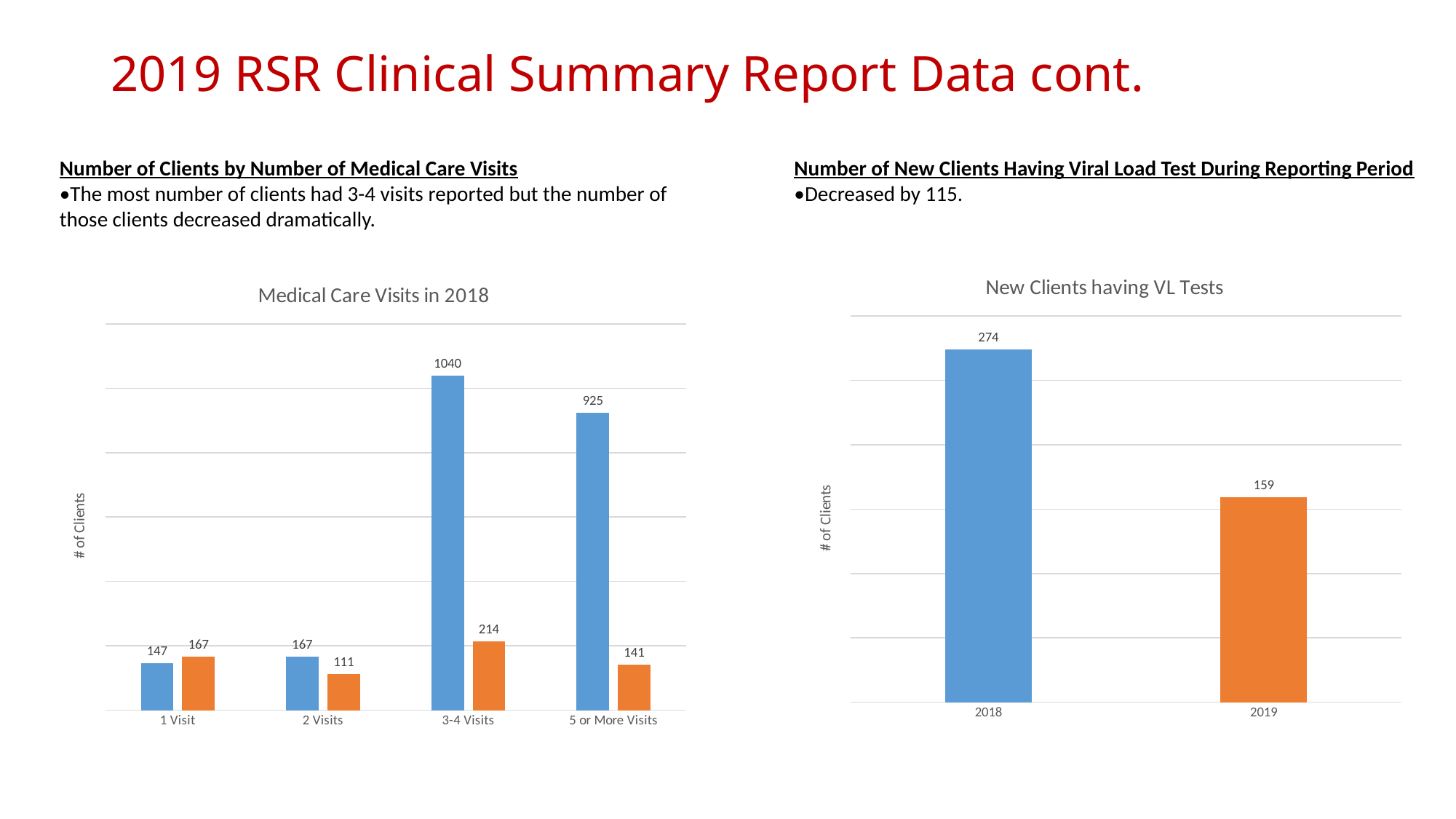
In the 'New Clients having VL Tests' chart, what is the difference between the 2018 and 2019 values? 115 In the 'Medical Care Visits in 2018' chart, what is the difference between the blue bars for 3-4 Visits and 5 or More Visits? 115 How many categories are shown on the x axis of the 'Medical Care Visits in 2018' chart? 4 In the 'New Clients having VL Tests' chart, do the values rise or fall from 2018 to 2019? fall In the 'Medical Care Visits in 2018' chart, what is the value of the blue bar for 3-4 Visits? 1040 In the 'Medical Care Visits in 2018' chart, what is the value of the orange bar for 2 Visits? 111 In the 'New Clients having VL Tests' chart, what is the value for 2018? 274 In the 'Medical Care Visits in 2018' chart, which category has the highest blue bar? 3-4 Visits In the 'Medical Care Visits in 2018' chart, which category has the lowest orange bar? 2 Visits What is the y-axis label of the 'New Clients having VL Tests' chart? # of Clients What kind of chart is 'Medical Care Visits in 2018'? bar chart In the 'Medical Care Visits in 2018' chart, which is larger for 1 Visit: the blue bar or the orange bar? the orange bar